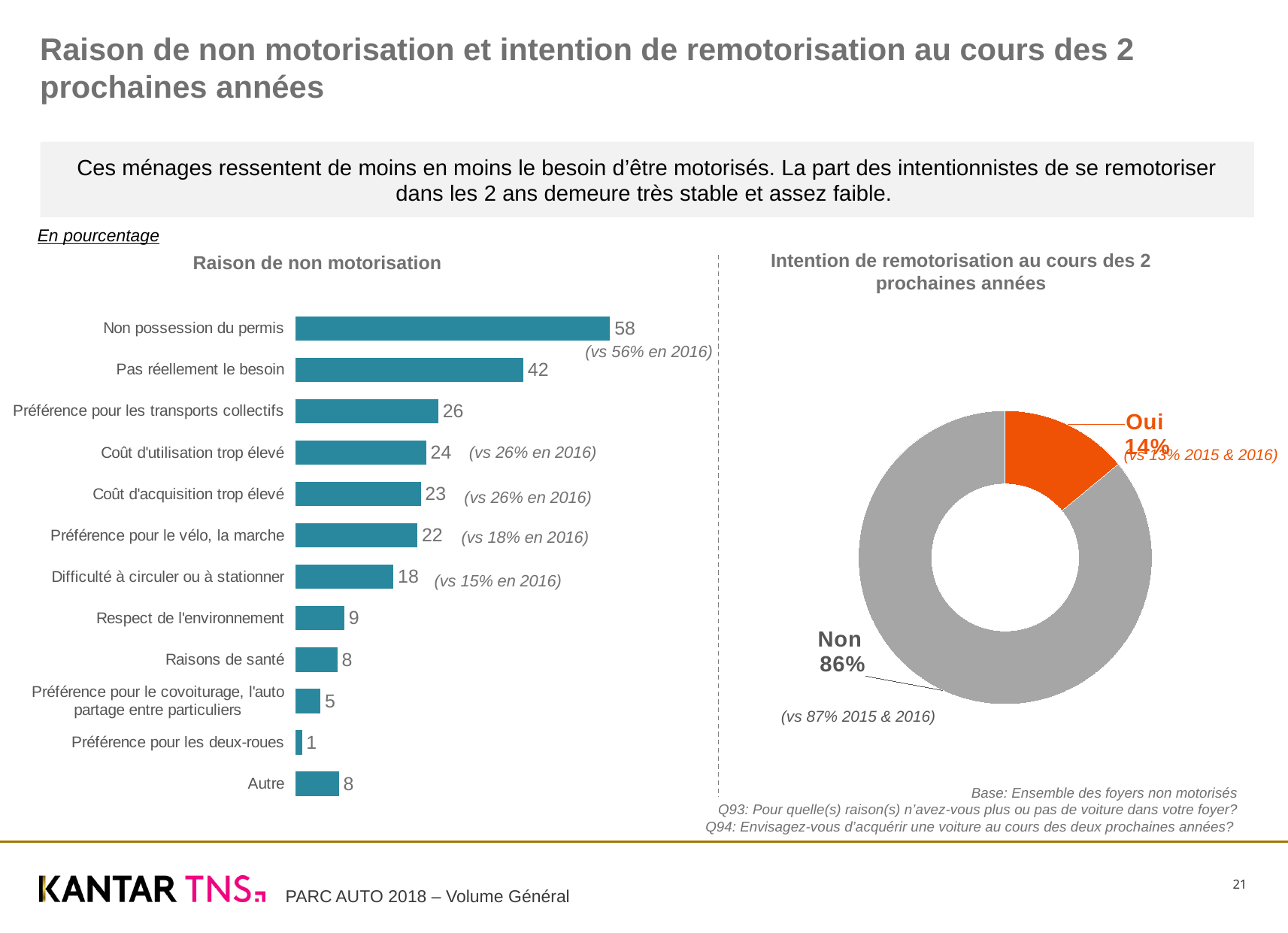
In the 'Raison de non motorisation' chart, which category has the highest value? Non possession du permis In the 'Raison de non motorisation' chart, what is the value for 'Préférence pour le vélo, la marche'? 22 In the 'Raison de non motorisation' chart, what is the difference between 'Non possession du permis' and 'Pas réellement le besoin'? 16 In the 'Raison de non motorisation' chart, what is the value for 'Non possession du permis'? 58 In the 'Raison de non motorisation' chart, which category has the lowest value? Préférence pour les deux-roues What kind of chart is 'Raison de non motorisation'? Bar chart In the 'Intention de remotorisation au cours des 2 prochaines années' chart, what is the share for 'Oui'? 14% How many categories are shown in the 'Raison de non motorisation' chart? 12 In the 'Raison de non motorisation' chart, which is larger: 'Préférence pour les transports collectifs' or 'Difficulté à circuler ou à stationner'? Préférence pour les transports collectifs What kind of chart is 'Intention de remotorisation au cours des 2 prochaines années'? Doughnut chart In the 'Intention de remotorisation au cours des 2 prochaines années' chart, what is the share for 'Non'? 86% In the 'Raison de non motorisation' chart, what was the 2016 value noted next to 'Difficulté à circuler ou à stationner'? 15%